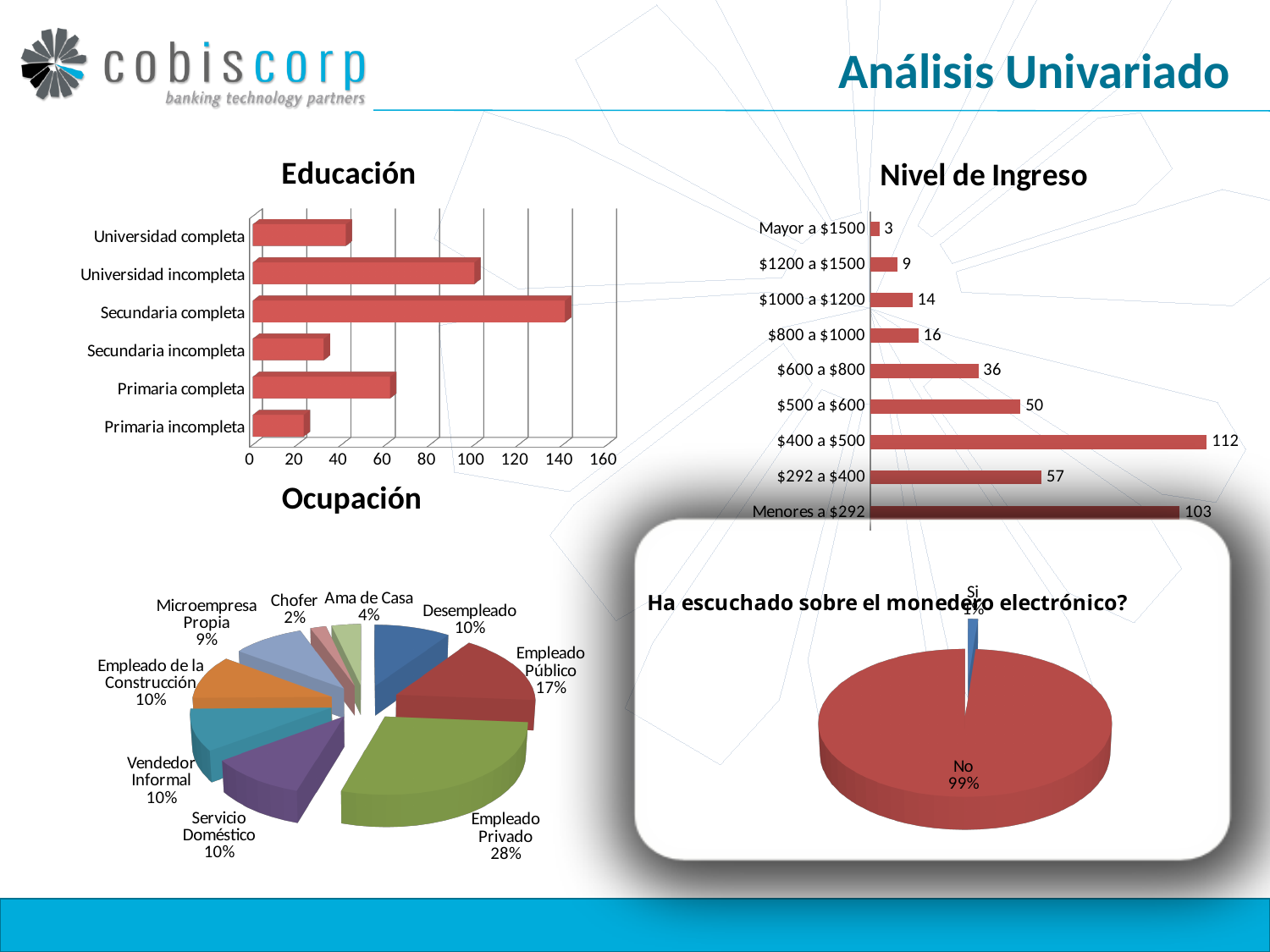
How many categories are shown in the 'Nivel de Ingreso' chart? 9 In the 'Nivel de Ingreso' chart, what is the value for '$400 a $500'? 112 In the 'Nivel de Ingreso' chart, what is the value for 'Menores a $292'? 103 In the 'Educación' chart, which category has the highest value? Secundaria completa In the 'Educación' chart, is the value for 'Universidad incompleta' greater or less than 80? greater In the 'Educación' chart, is the value for 'Primaria incompleta' greater or less than 40? less What kind of chart is the 'Educación' chart? bar chart In the 'Ocupación' pie chart, what share does 'Empleado Privado' have? 28% In the 'Ocupación' pie chart, which category has the smallest share? Chofer In the 'Nivel de Ingreso' chart, what is the difference between '$400 a $500' and '$292 a $400'? 55 In the 'Ha escuchado sobre el monedero electrónico?' pie chart, what share answered 'No'? 99% In the 'Nivel de Ingreso' chart, which category has the lowest value? Mayor a $1500